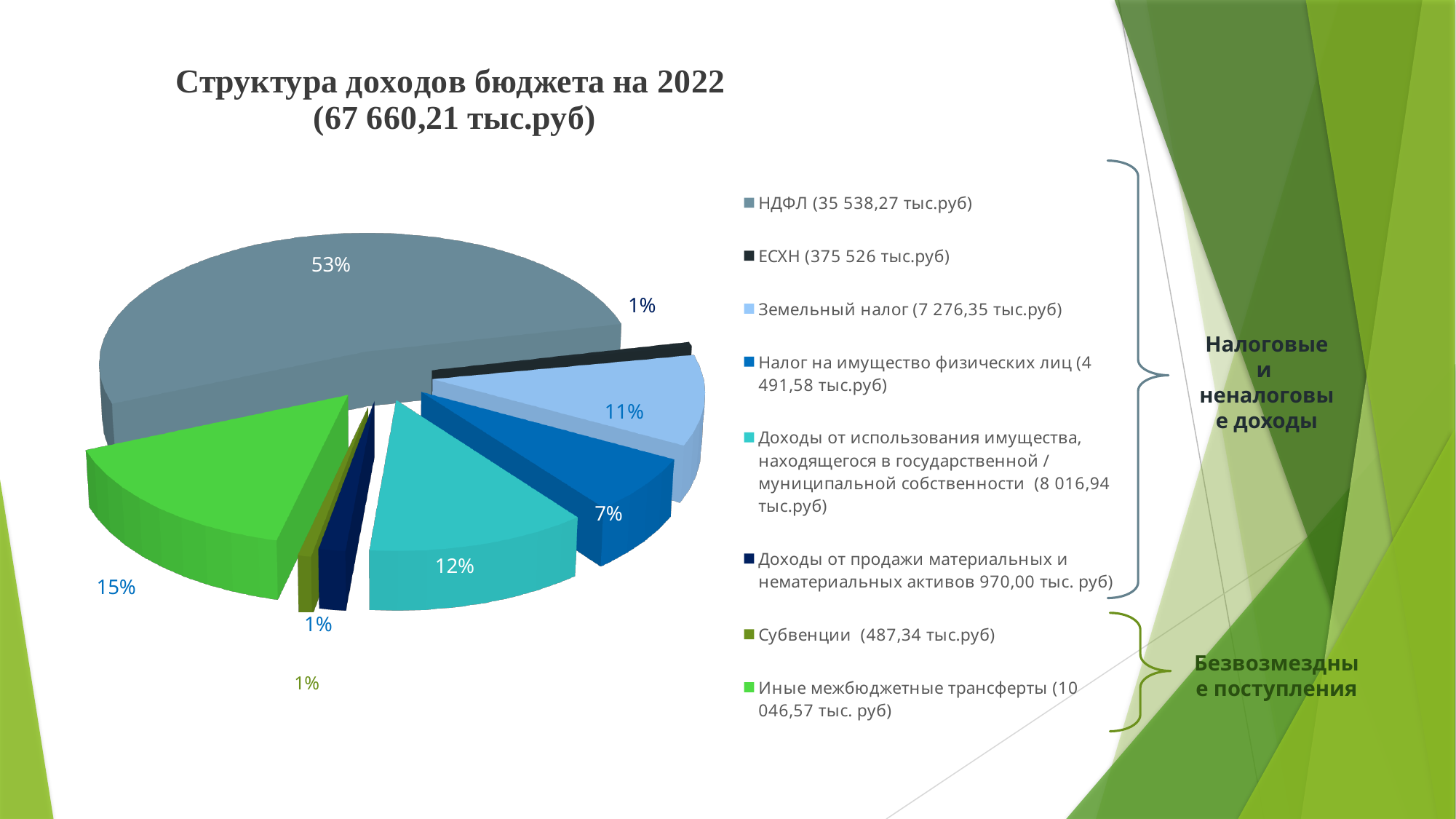
What kind of chart is shown on the slide? pie chart What share of the pie does Земельный налог (7 276,35 тыс.руб) take? 11% What share of the pie does НДФЛ (35 538,27 тыс.руб) take? 53% What share of the pie does Субвенции (487,34 тыс.руб) take? 1% How many entries does the chart legend list? 8 Which is larger: the slice for Иные межбюджетные трансферты or the slice for Доходы от использования имущества? Иные межбюджетные трансферты Which category has the largest slice of the pie? НДФЛ (35 538,27 тыс.руб) What is the title of the chart? Структура доходов бюджета на 2022 (67 660,21 тыс.руб) What is the difference in percentage points between the НДФЛ slice and the Иные межбюджетные трансферты slice? 38%